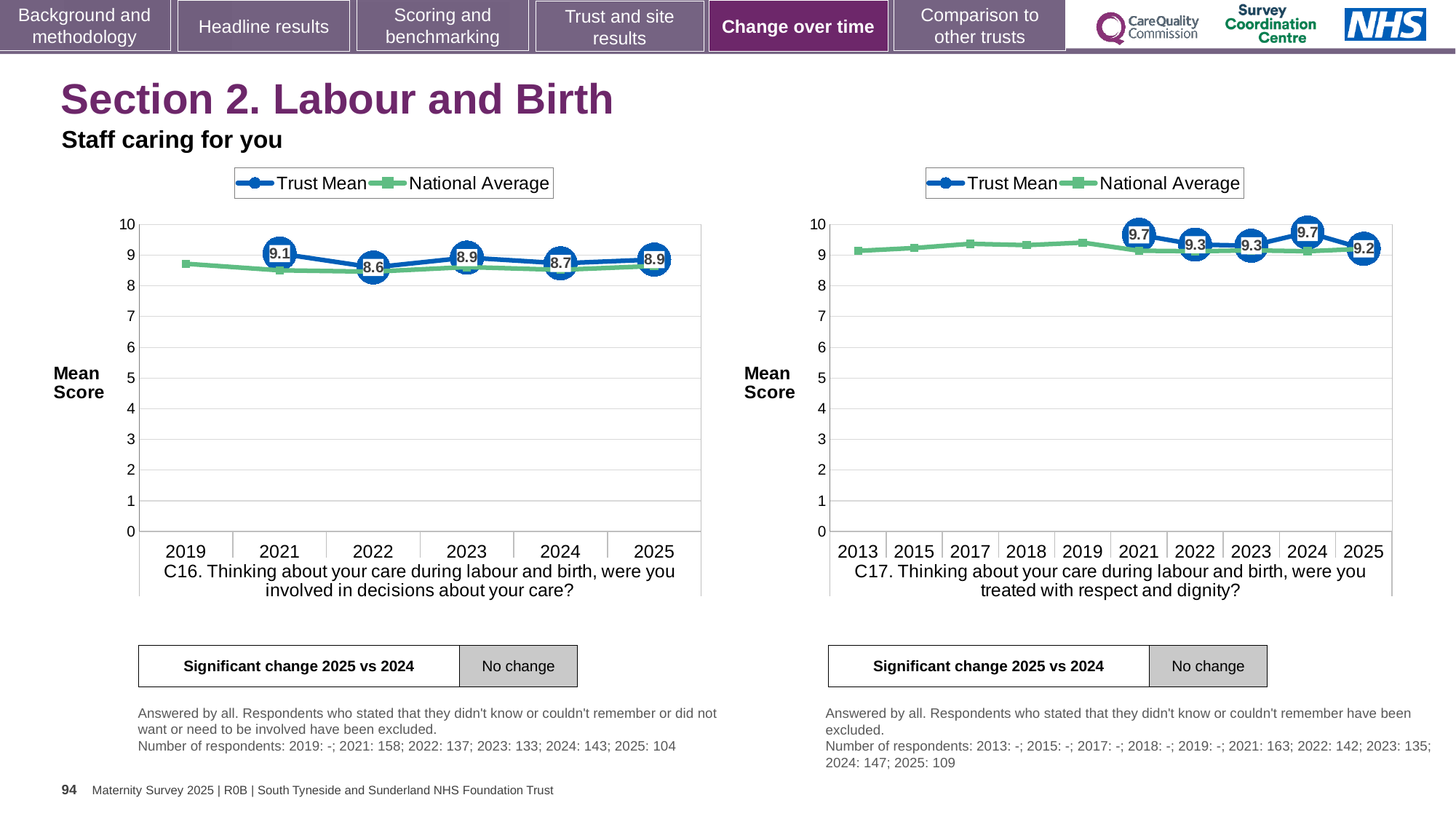
On the C16 chart (left), in which year is the Trust Mean score highest? 2021 What type of chart is the C16 chart (left)? Line chart On the C16 chart (left), is the National Average value for 2019 greater or less than 8? greater On the C16 chart (left), in which year is the Trust Mean score lowest? 2022 On the C17 chart (right), what is the difference between the Trust Mean scores for 2024 and 2025? 0.5 On the C17 chart (right), in which year is the Trust Mean score lowest? 2025 How many years are shown on the x axis of the C17 chart (right)? 10 On the C17 chart (right), what is the Trust Mean score for 2022? 9.3 On the C17 chart (right), what is the Trust Mean score for 2025? 9.2 On the C16 chart (left), what is the Trust Mean score for 2021? 9.1 On the C16 chart (left), what is the Trust Mean score for 2025? 8.9 On the C16 chart (left), which year has the larger Trust Mean score, 2022 or 2023? 2023